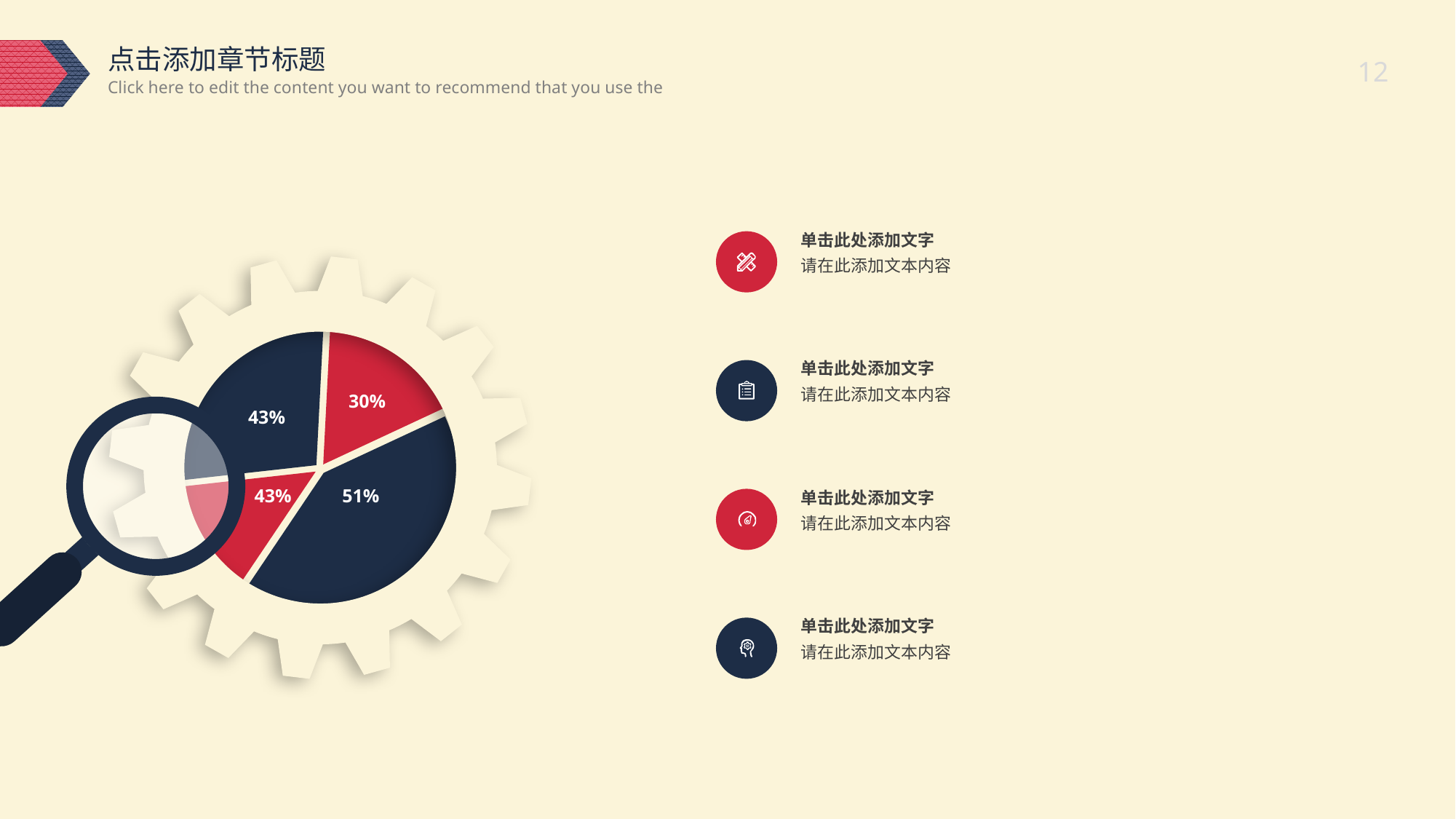
What value is labelled on the large dark navy slice at the bottom right of the pie chart? 51% What kind of chart is shown inside the gear on the slide? Pie chart How many slices does the pie chart have? 4 What value is labelled on the red slice at the lower left of the pie chart? 43% What value is labelled on the dark navy slice at the upper left of the pie chart? 43% How many different colours are used for the slices of the pie chart? 2 Which is larger in the pie chart: the red slice at the top right or the dark navy slice at the bottom right? The dark navy slice at the bottom right (51%) How many slices of the pie chart are labelled 43%? 2 What is the smallest value labelled on the pie chart? 30% What is the difference between the largest labelled slice (51%) and the smallest labelled slice (30%) in the pie chart? 21 percentage points What is the largest value labelled on the pie chart? 51% What value is labelled on the red slice at the top right of the pie chart? 30%